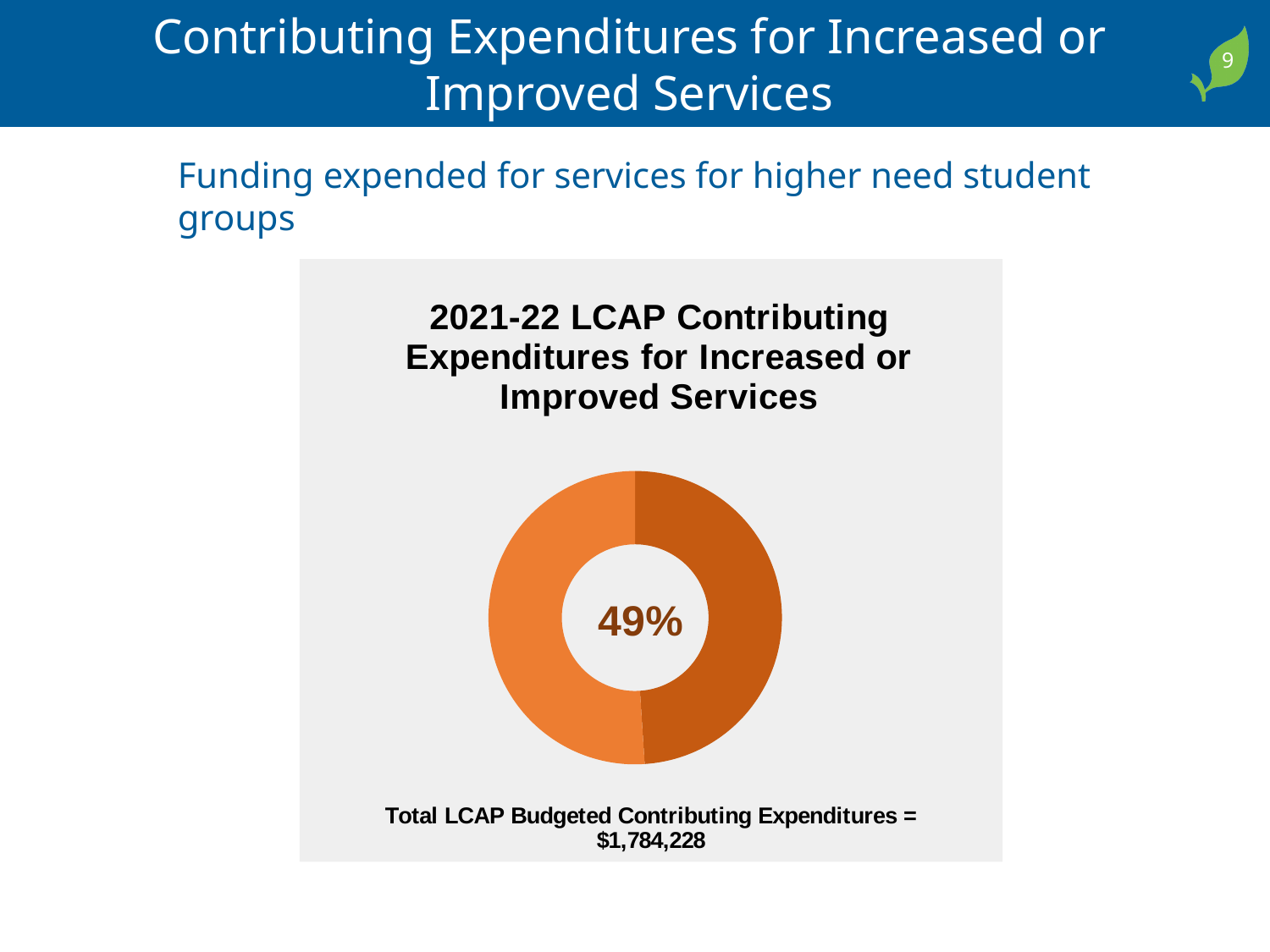
What kind of chart is shown on the slide? Pie chart (donut) Does the chart include a legend? No What is the title of the chart? 2021-22 LCAP Contributing Expenditures for Increased or Improved Services How many slices does the donut chart have? 2 Is the percentage printed in the centre of the donut chart greater or less than 50%? less What total LCAP budgeted contributing expenditures amount is printed below the chart? $1,784,228 What percentage is printed in the centre of the donut chart? 49%